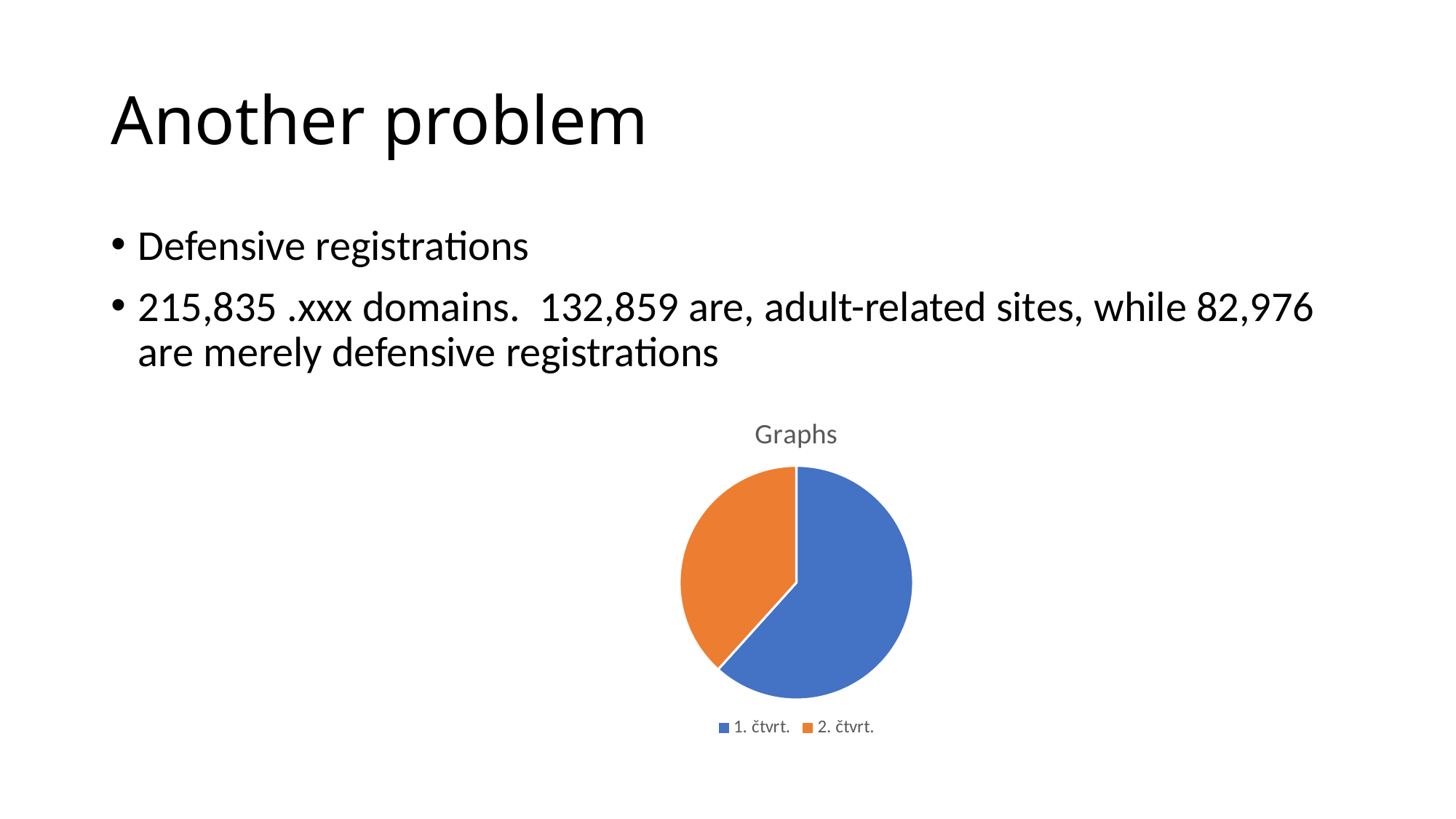
What kind of chart is shown on the slide? pie chart How many slices does the pie chart have? 2 Which slice is larger, 1. čtvrt. or 2. čtvrt.? 1. čtvrt. How many entries does the chart legend list? 2 What colour is the slice for 1. čtvrt.? blue Which slice of the pie chart is the largest? 1. čtvrt. What is the title of the chart? Graphs Which slice of the pie chart is the smallest? 2. čtvrt.